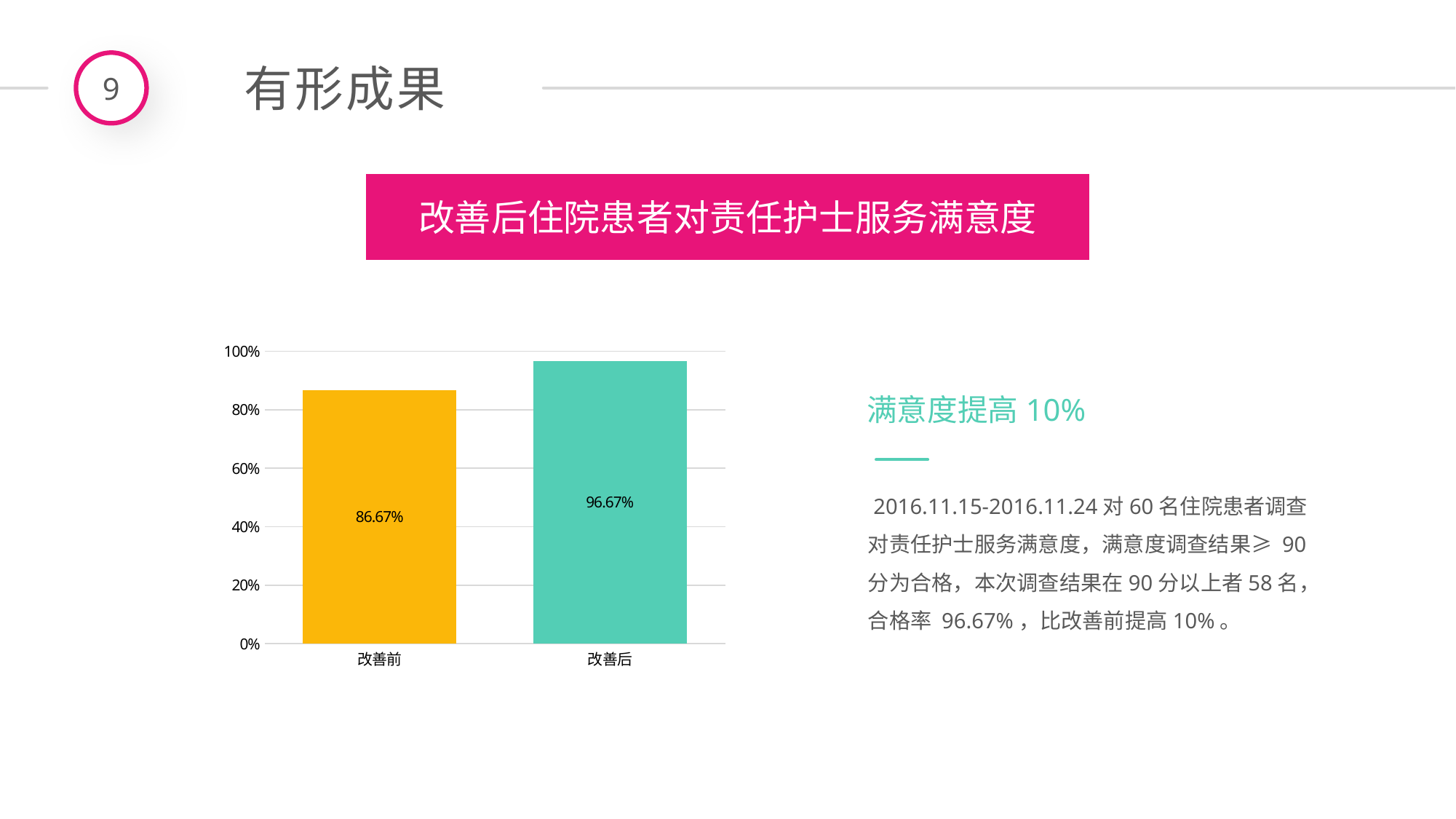
Which category has the highest value? 改善后 What colour is the bar for 改善后? teal (green) Is the value for 改善前 greater or less than 80%? greater What is the value for 改善前? 86.67% What is the difference between the values for 改善后 and 改善前? 10% Which is larger, the value for 改善前 or the value for 改善后? 改善后 Is the value for 改善后 greater or less than 100%? less What is the value for 改善后? 96.67% Which category has the lowest value? 改善前 How many categories are shown on the x axis? 2 Do the values rise or fall from 改善前 to 改善后? rise What kind of chart is shown on the slide? bar chart